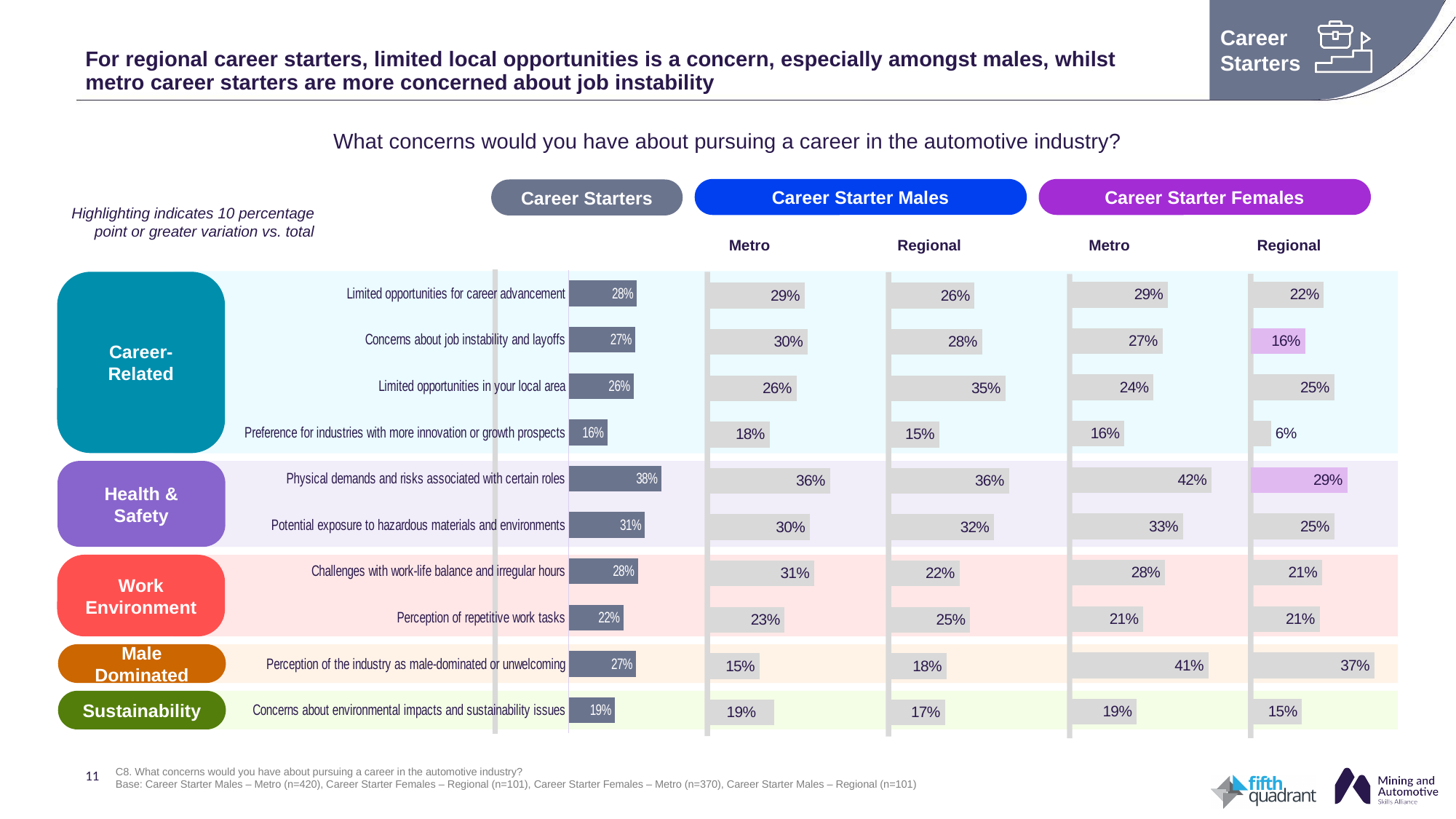
In the Career Starter Males Regional column, what is the value for 'Limited opportunities in your local area'? 35% In the Career Starters (total) column, what is the value for 'Physical demands and risks associated with certain roles'? 38% In the Career Starters (total) column, which concern has the highest value? Physical demands and risks associated with certain roles What is the difference between the Career Starter Males Regional and Career Starter Males Metro values for 'Limited opportunities in your local area'? 9 percentage points According to the note on the slide, what does highlighting indicate? 10 percentage point or greater variation vs. total In the Career Starter Females Regional column, which concern has the lowest value? Preference for industries with more innovation or growth prospects In the Career Starter Females Regional column, what is the value for 'Preference for industries with more innovation or growth prospects'? 6% In the Career Starter Females Metro column, what is the value for 'Perception of the industry as male-dominated or unwelcoming'? 41% What is the difference between the Career Starter Females Metro and Career Starter Males Metro values for 'Perception of the industry as male-dominated or unwelcoming'? 26 percentage points What type of chart is used to display the values on this slide? Bar chart For 'Concerns about job instability and layoffs', which is larger: the Career Starter Males Metro value or the Career Starter Females Regional value? Career Starter Males Metro How many concern categories are listed on the chart? 10